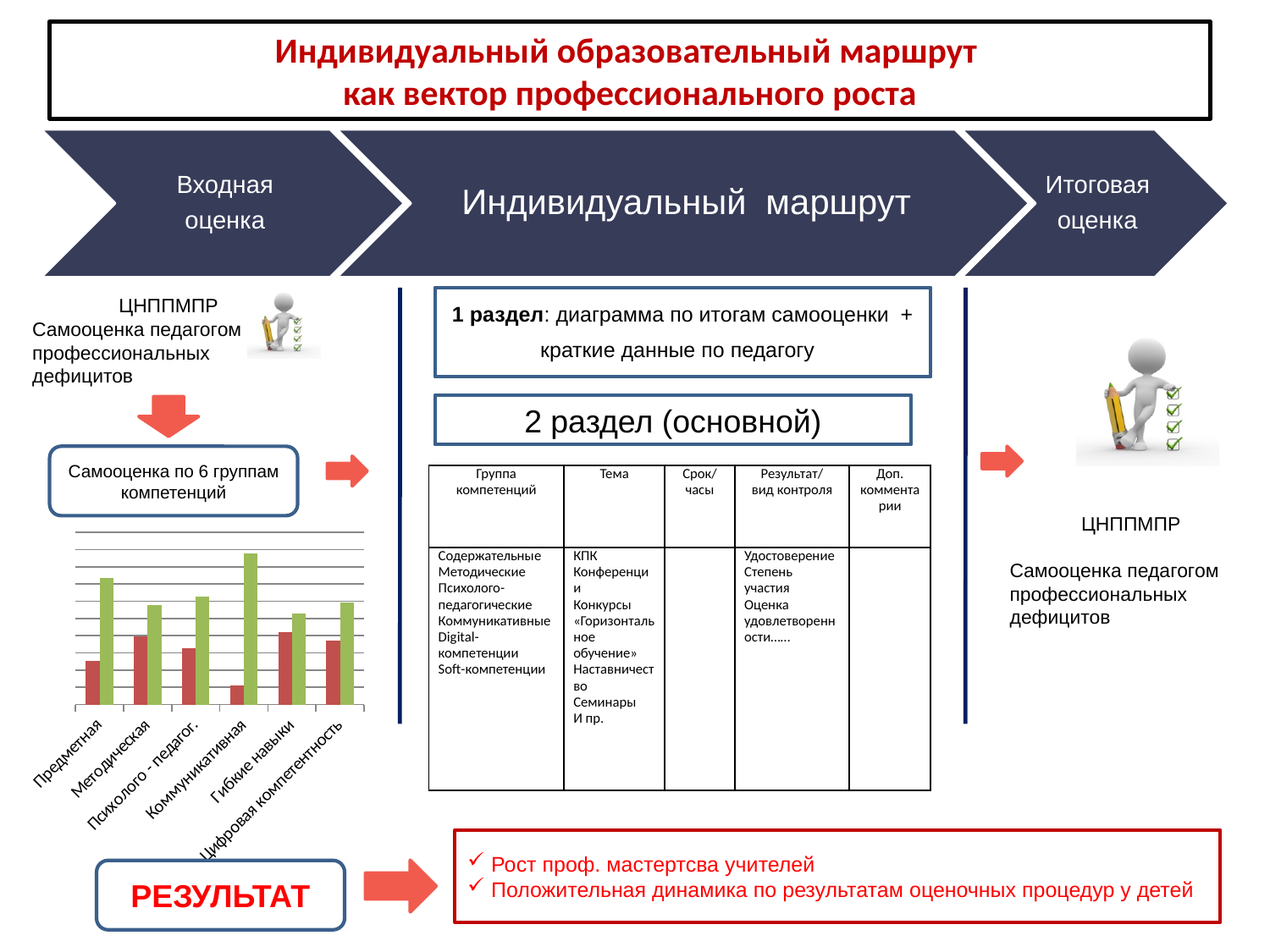
Which category has the taller red bar, Предметная or Гибкие навыки? Гибкие навыки What two colours are used for the bars in the bar chart? red and green Which category has the shortest red bar in the bar chart? Коммуникативная How many categories are shown on the x axis of the bar chart? 6 Which category has the taller green bar, Коммуникативная or Предметная? Коммуникативная Which category has the tallest green bar in the bar chart? Коммуникативная How many bars are plotted for each category in the bar chart? 2 For the category Коммуникативная, which bar is taller, the red one or the green one? green What is the label of the first category on the x axis of the bar chart? Предметная What kind of chart is shown on the left side of the slide under "Самооценка по 6 группам компетенций"? bar chart